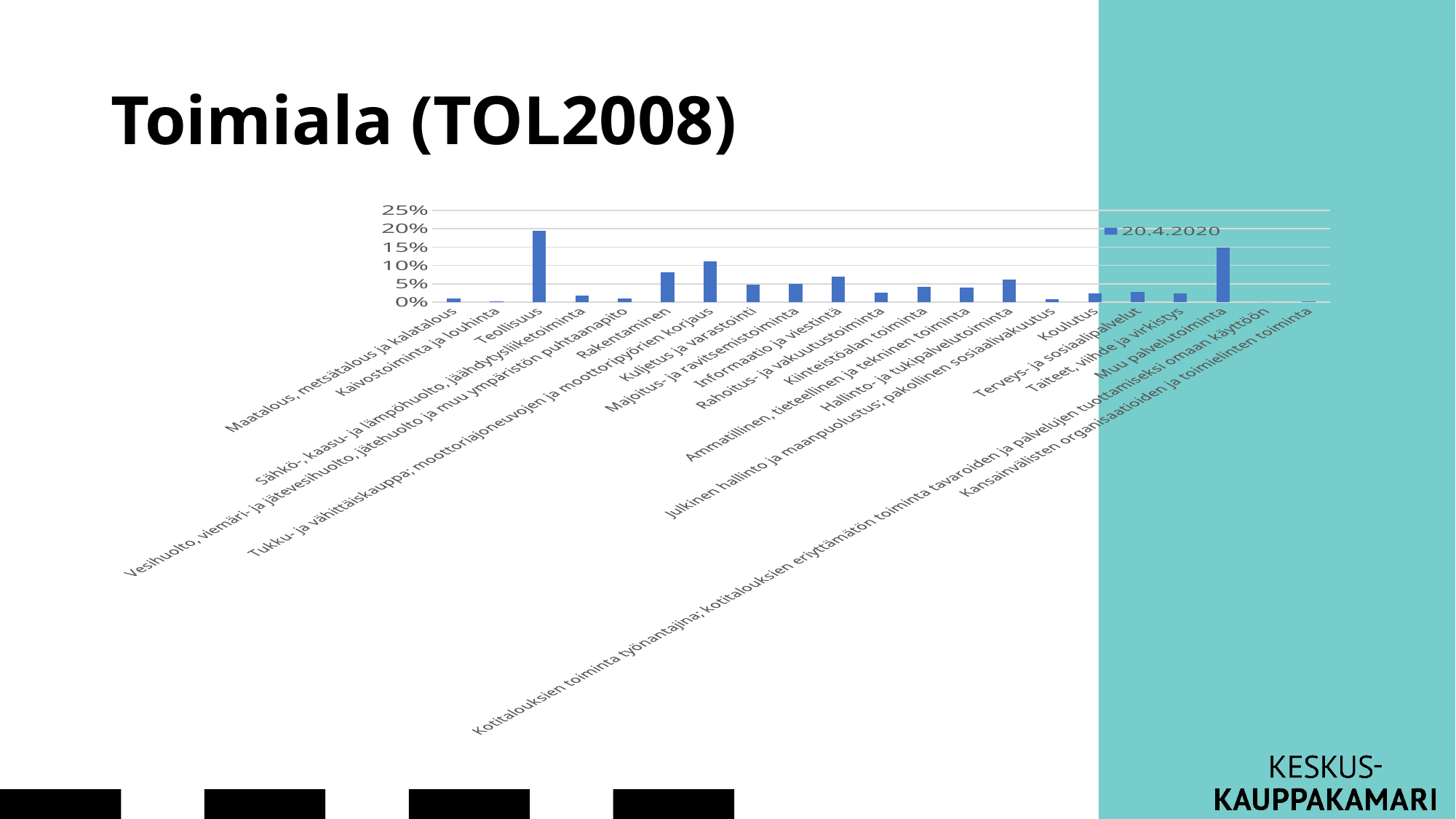
Is the value for Teollisuus greater or less than 15%? greater Is the value for Muu palvelutoiminta greater or less than 20%? less Which category has the highest value in the chart? Teollisuus Is the value for Koulutus greater or less than 5%? less How many series does the legend list? 1 How many categories are shown on the x axis of the chart? 21 Which is larger, the value for Teollisuus or the value for Muu palvelutoiminta? Teollisuus Which is larger, the value for Kuljetus ja varastointi or the value for Rakentaminen? Rakentaminen What is the series name shown in the legend? 20.4.2020 What is the highest value shown on the y axis of the chart? 25% What kind of chart is shown on the slide? bar chart